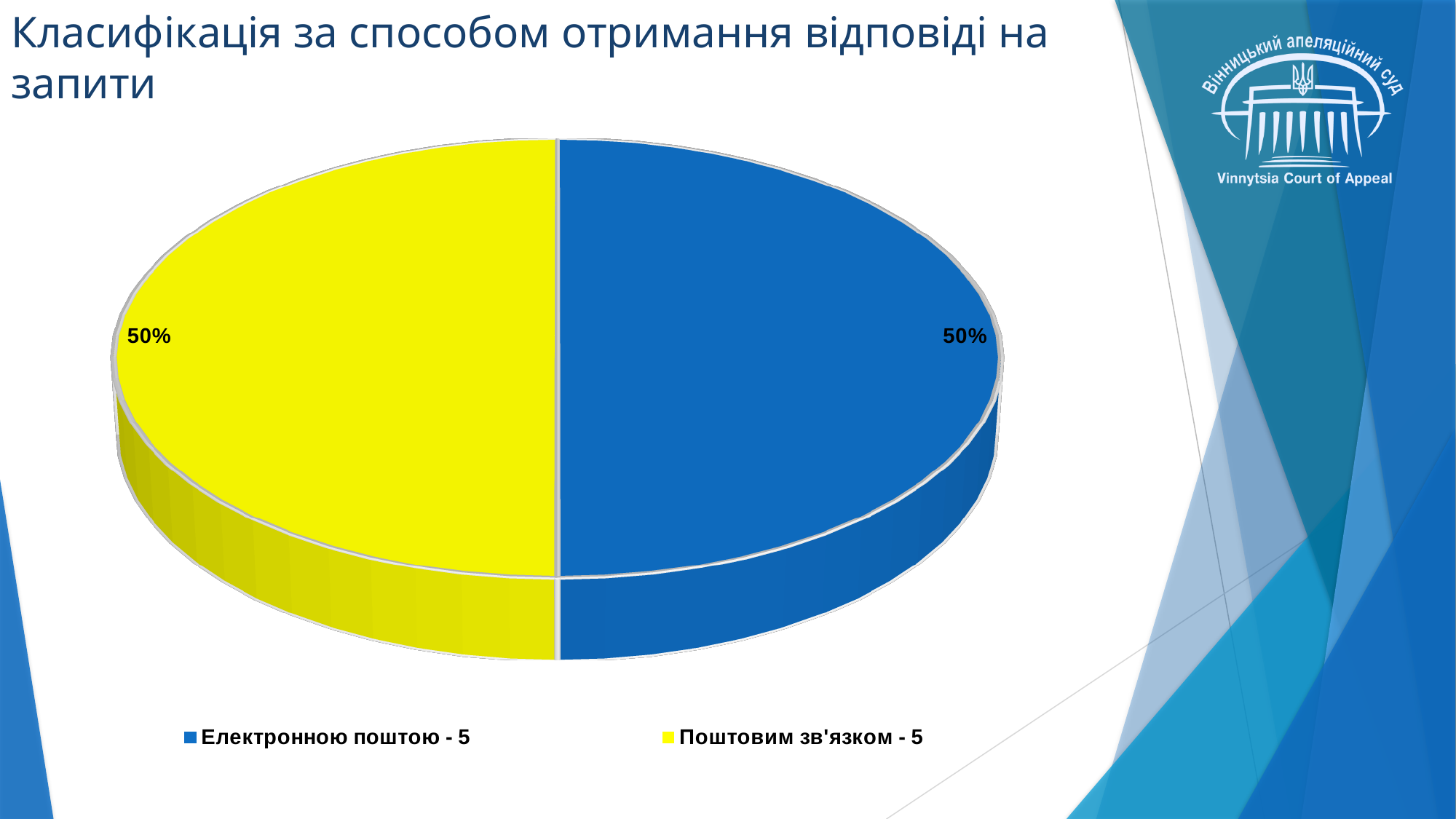
How many slices does the pie chart have? 2 What is the title of the slide containing the pie chart? Класифікація за способом отримання відповіді на запити Which colour represents "Поштовим зв'язком - 5" in the pie chart? yellow What share of the pie does "Електронною поштою - 5" represent? 50% What is the difference between the percentage shares of the two slices? 0% What kind of chart is shown on the slide? pie chart How many entries does the legend list? 2 What is the total of the two percentage labels shown on the pie chart? 100% What share of the pie does "Поштовим зв'язком - 5" represent? 50%